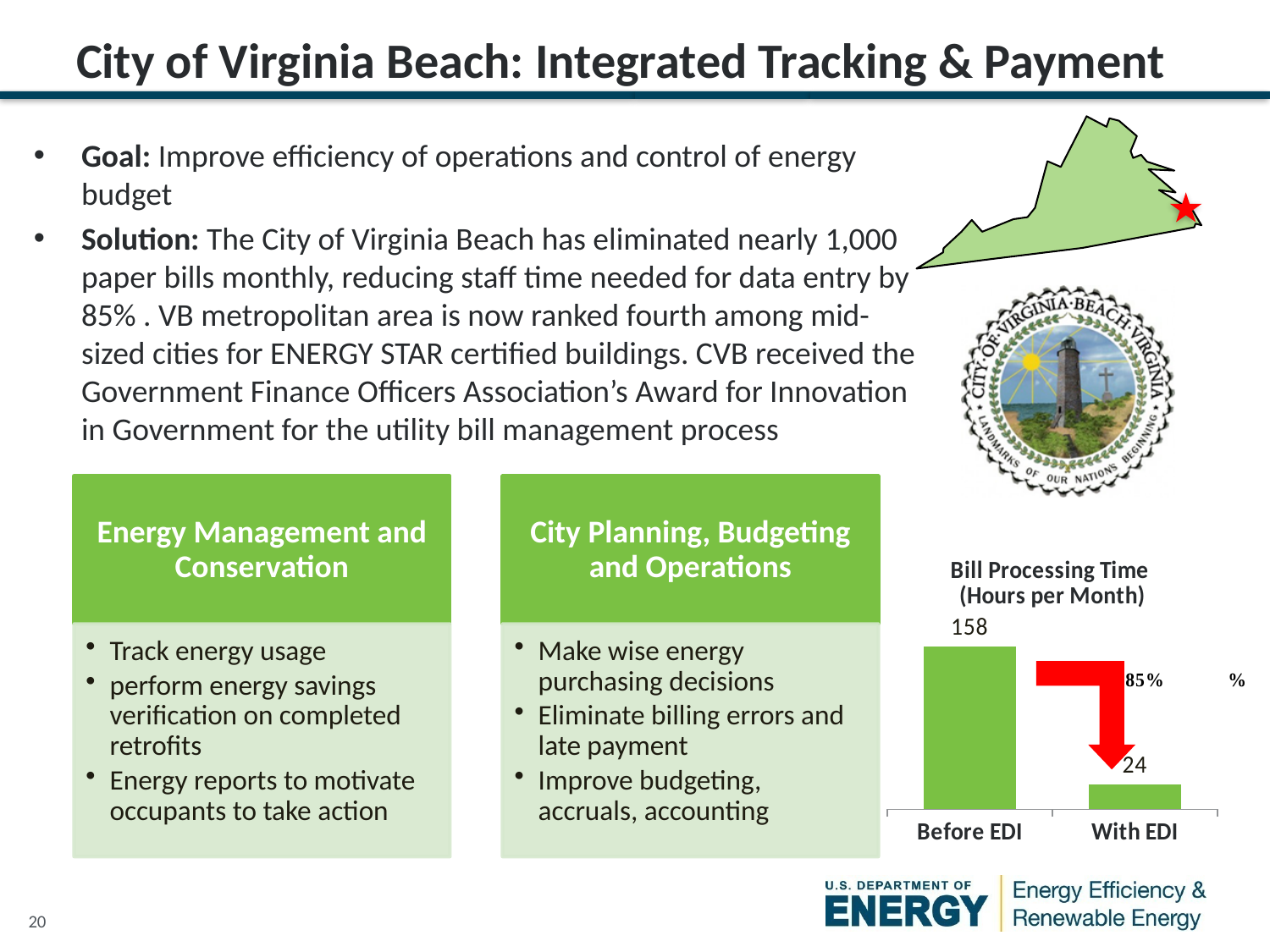
What is the difference in bill processing time between Before EDI and With EDI? 134 What kind of chart is the Bill Processing Time chart? Bar chart What percentage reduction is indicated by the red arrow on the Bill Processing Time chart? 85% Do the values in the Bill Processing Time chart rise or fall from Before EDI to With EDI? Fall What is the title of the chart on the slide? Bill Processing Time (Hours per Month) What is the Bill Processing Time (Hours per Month) for Before EDI? 158 Which category has the lowest bill processing time? With EDI How many categories are shown in the Bill Processing Time chart? 2 Which category has the higher bill processing time, Before EDI or With EDI? Before EDI What is the Bill Processing Time (Hours per Month) for With EDI? 24 Which category has the highest bill processing time? Before EDI